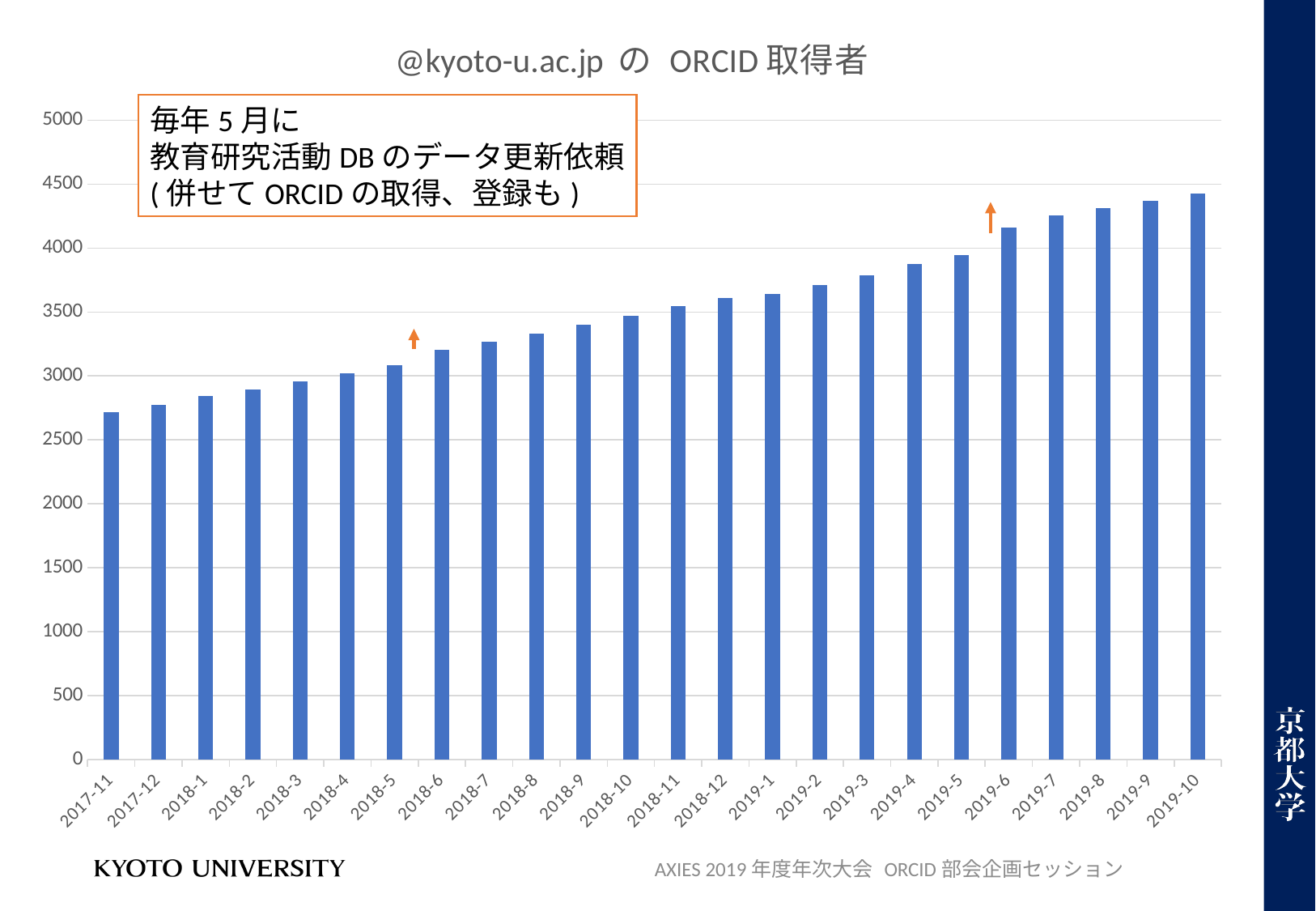
What is the title of the chart? @kyoto-u.ac.jp の ORCID取得者 Is the value for 2018-6 greater or less than 3000? greater Is the value for 2019-1 greater or less than 3500? greater Which is larger, the value for 2018-6 or the value for 2019-6? 2019-6 What kind of chart is shown on the slide? bar chart Is the value for 2019-6 greater or less than 4000? greater Which month has the highest number of ORCID holders? 2019-10 How many months (bars) are plotted on the chart? 24 Do the values rise or fall from 2017-11 to 2019-10? rise Which month has the lowest number of ORCID holders? 2017-11